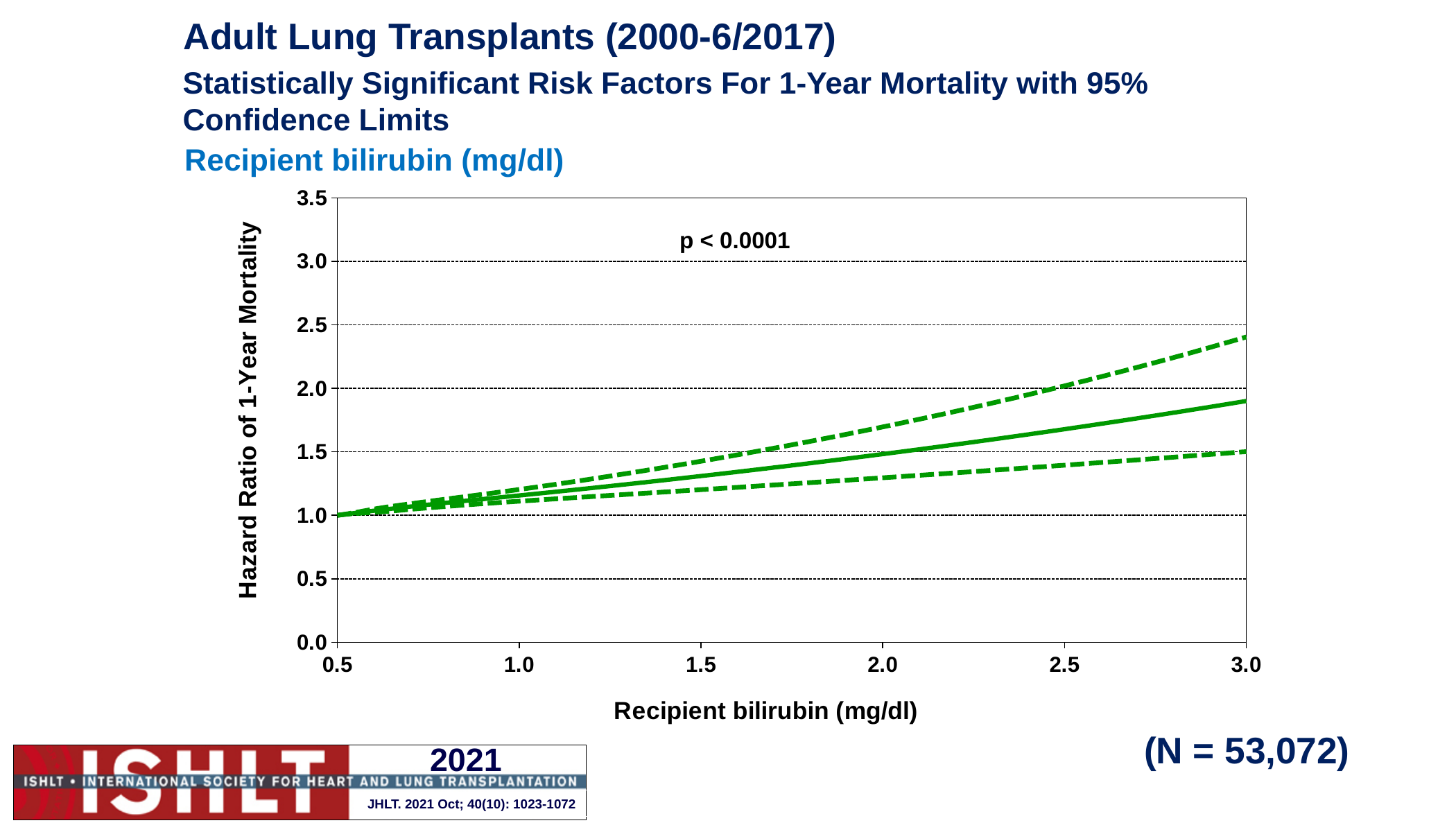
What p-value is printed on the chart? p < 0.0001 Is the upper 95% confidence limit (upper dashed line) at a recipient bilirubin of 3.0 mg/dl greater or less than 2.5? less What is the label of the y axis? Hazard Ratio of 1-Year Mortality Is the lower 95% confidence limit (lower dashed line) at a recipient bilirubin of 2.0 mg/dl greater or less than 1.5? less What is the sample size (N) shown on the slide? N = 53,072 Is the upper 95% confidence limit (upper dashed line) at a recipient bilirubin of 3.0 mg/dl greater or less than 2.0? greater Does the hazard ratio rise or fall as recipient bilirubin increases along the x axis? rises What is the hazard ratio of 1-year mortality at a recipient bilirubin of 0.5 mg/dl? 1.0 How many lines are plotted on the chart? 3 What kind of chart is shown on the slide? line chart